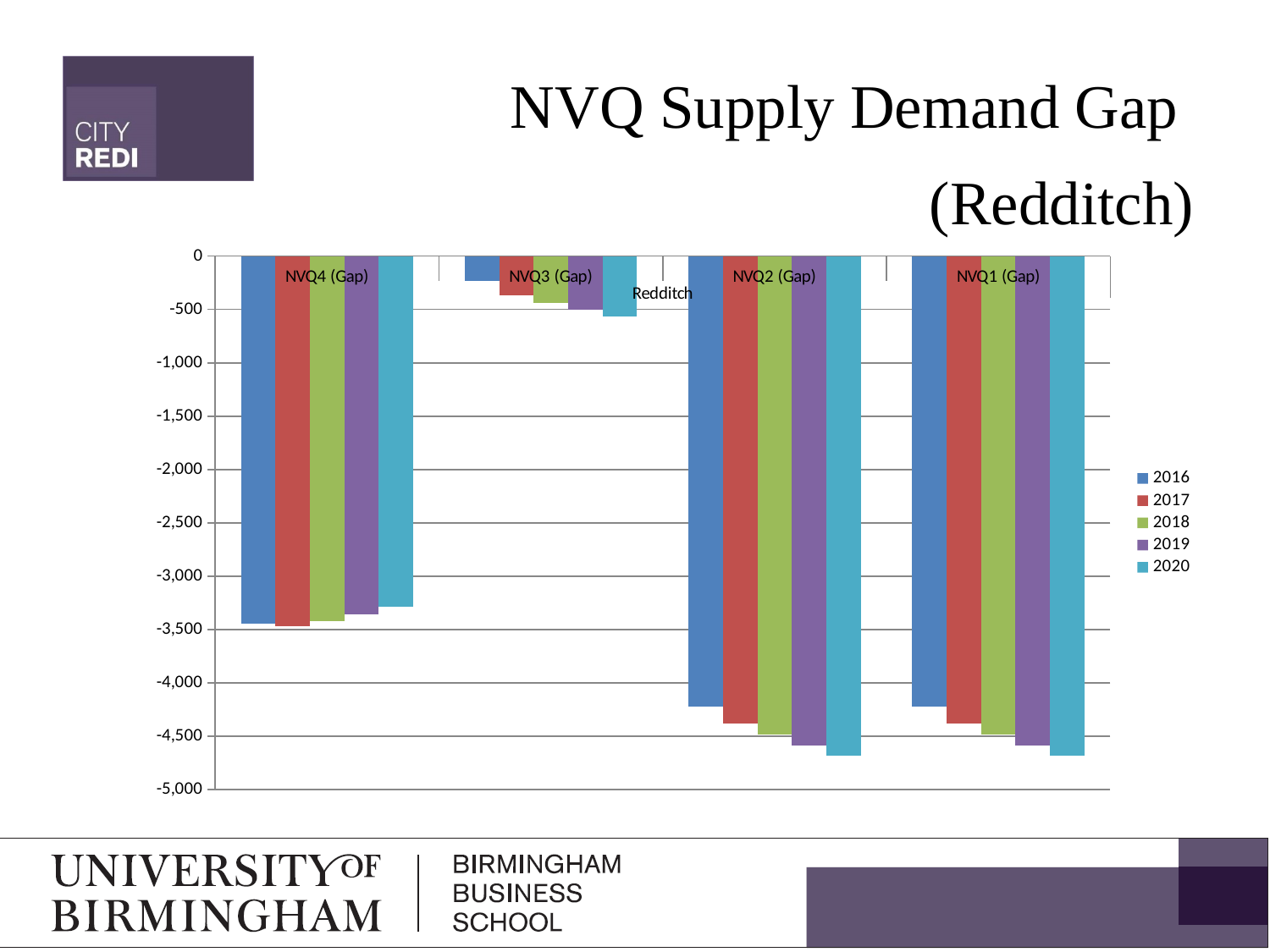
Which NVQ category has the smallest gap (bars closest to zero)? NVQ3 (Gap) For NVQ2 (Gap), do the values become more negative or less negative from 2016 to 2020? more negative What kind of chart is shown on the slide? bar chart Is the 2016 value for NVQ1 (Gap) greater or less than -4,000? less Is the 2020 value for NVQ2 (Gap) greater or less than -4,500? less Which area does the chart title say the NVQ supply demand gap is for? Redditch Which is larger (closer to zero), the 2016 value for NVQ4 (Gap) or the 2016 value for NVQ3 (Gap)? NVQ3 (Gap) How many series does the legend list? 5 Which years are listed in the legend? 2016, 2017, 2018, 2019, 2020 Is the 2020 value for NVQ3 (Gap) greater or less than -500? less How many NVQ gap categories are shown on the x axis? 4